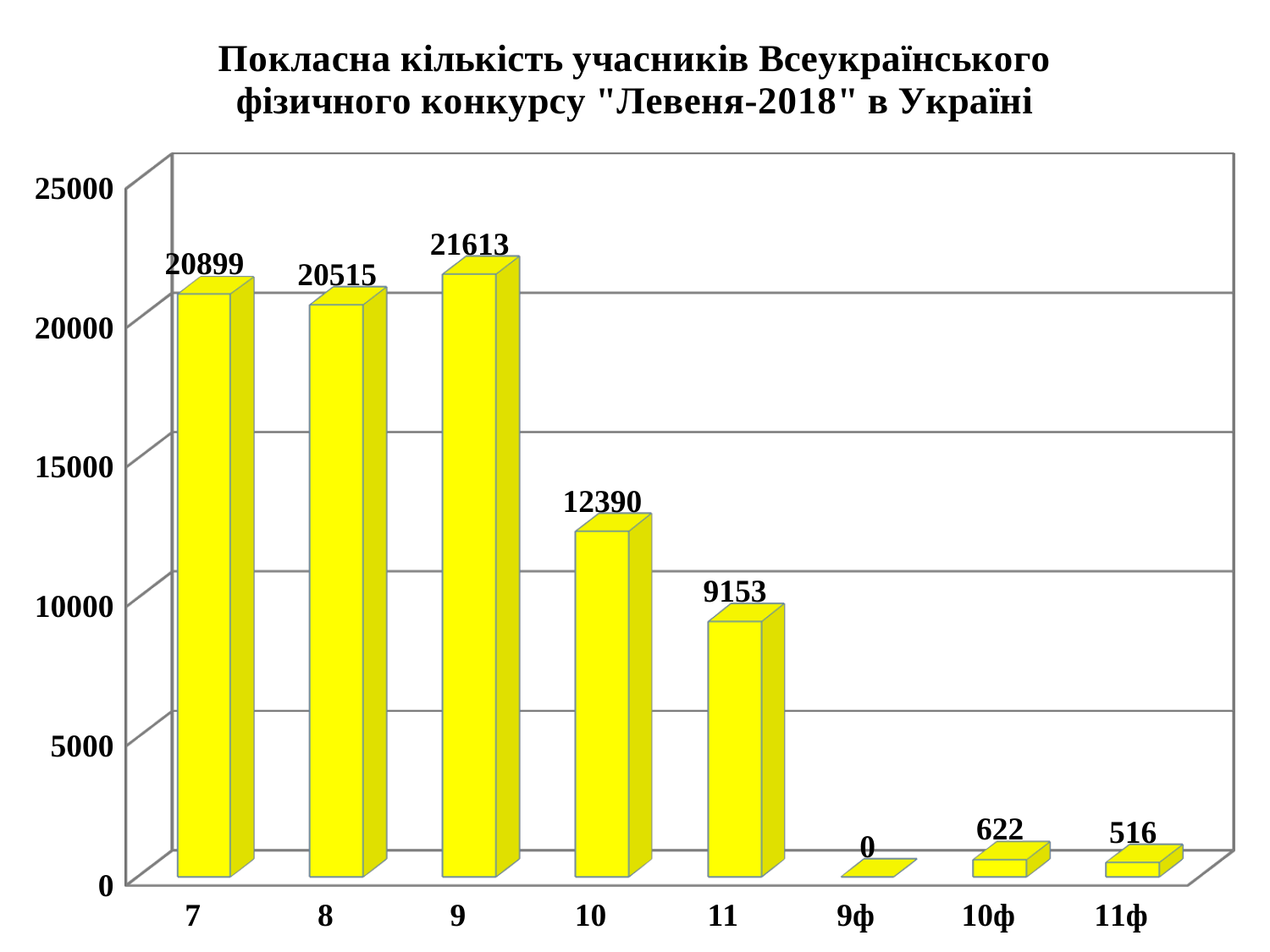
What is the number of participants for grade 9? 21613 What kind of chart is shown on the slide? bar chart Is the value for grade 10 greater or less than 15000? less How many categories are shown on the x axis? 8 Which category has the lowest number of participants? 9ф What is the value shown for category 10ф? 622 What colour are the bars in the chart? yellow What is the number of participants for grade 11? 9153 Which has more participants, grade 10 or grade 11? 10 What is the difference between the values for grade 7 and grade 8? 384 Which category has the highest number of participants? 9 What is the difference between the values for grade 10 and grade 11? 3237